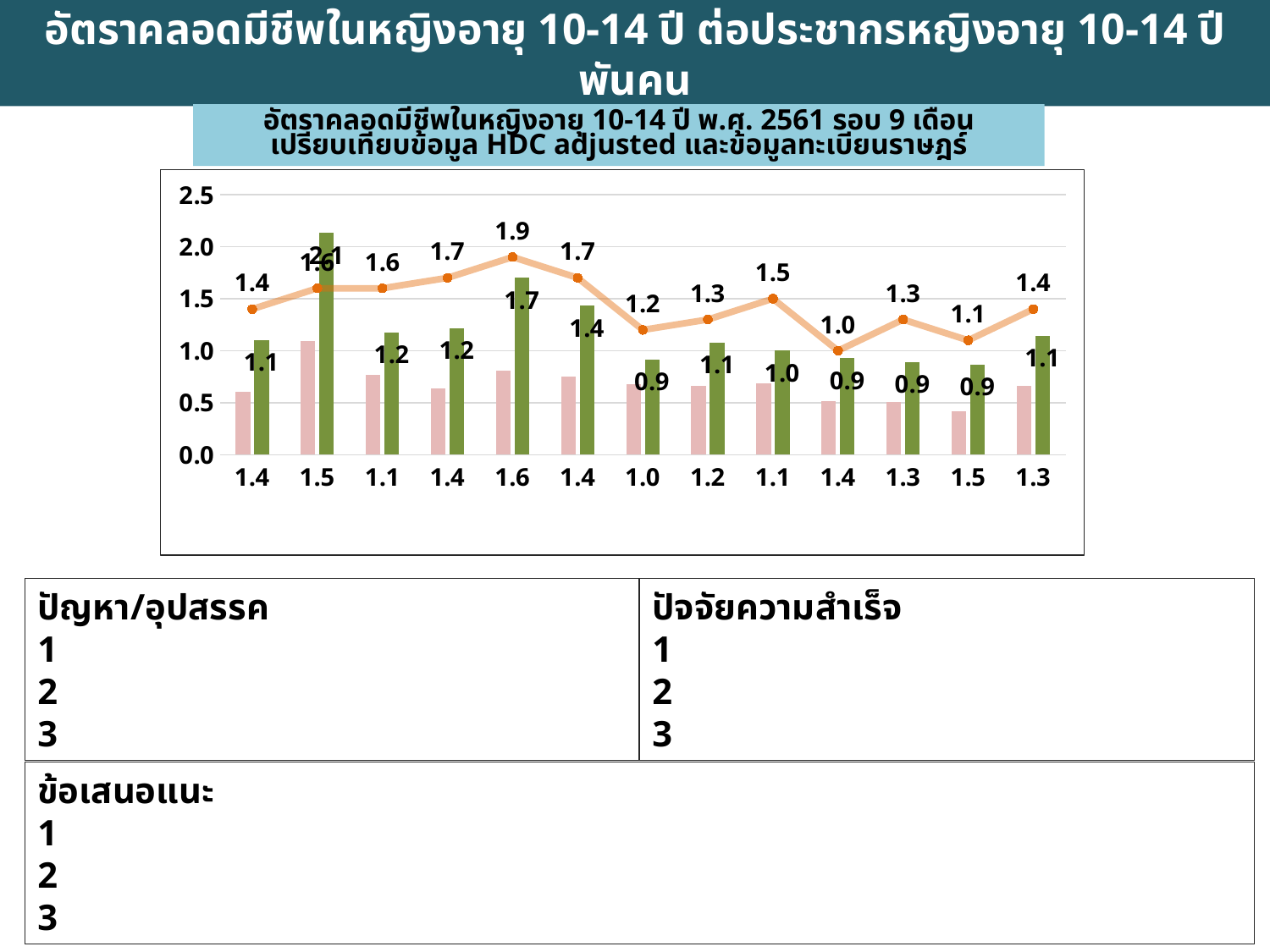
Is the value of the pink bar in the first category greater or less than 1.0? less What is the value of the orange line at the tenth point from the left? 1.0 Which green bar is the tallest in the chart? the second bar (2.1) What kind of chart is shown on the slide? combination bar and line chart At which position along the x axis does the orange line reach its highest value? fifth point (1.9) What is the value of the green bar in the last (thirteenth) category? 1.1 What is the value of the orange line at the fifth point from the left? 1.9 What is the value of the green bar in the second category from the left? 2.1 At which position along the x axis does the orange line reach its lowest value? tenth point (1.0) In the second category, which is larger: the green bar or the orange line value? the green bar How many categories are plotted along the x axis of the chart? 13 What is the difference between the orange line value and the green bar value in the fifth category? 0.2